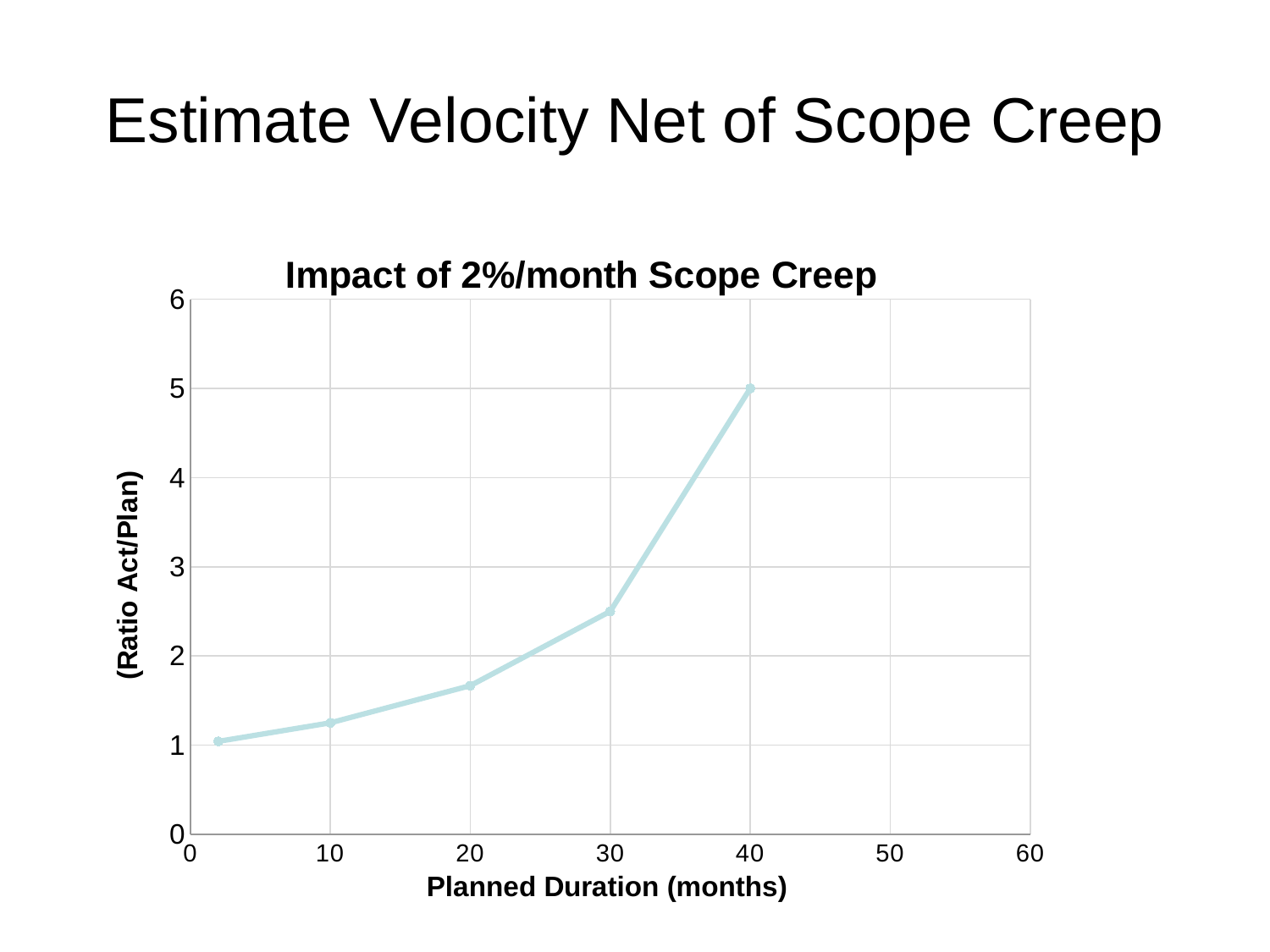
Does the ratio rise or fall as planned duration increases? rises Which has the larger ratio: a planned duration of 30 months or 40 months? 40 months Is the ratio at a planned duration of 30 months greater or less than 3? less Is the ratio at a planned duration of 30 months greater or less than 2? greater What kind of chart is shown on the slide? line chart Is the ratio at a planned duration of 20 months greater or less than 2? less What is the title of the chart? Impact of 2%/month Scope Creep How many data points are plotted on the line? 5 At which planned duration is the ratio highest? 40 months What is the ratio value at a planned duration of 40 months? 5 What is the label of the x axis? Planned Duration (months)